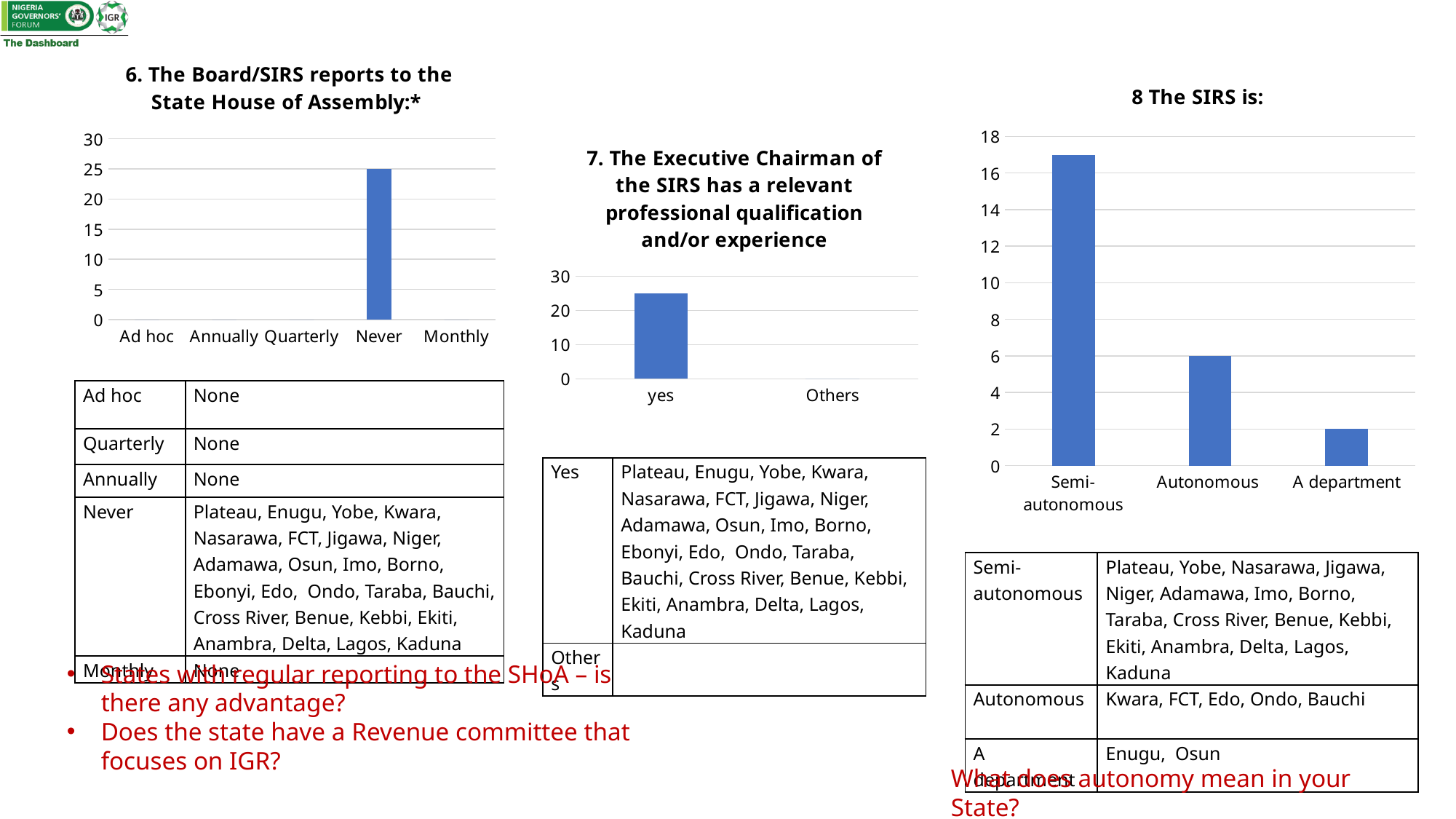
In the chart titled '8 The SIRS is:', which category has the highest value? Semi-autonomous In the chart titled '8 The SIRS is:', which category has the lowest value? A department In the chart titled '8 The SIRS is:', is the value for Semi-autonomous greater or less than 16? greater In the chart titled '8 The SIRS is:', what is the value for A department? 2 In the chart titled '6. The Board/SIRS reports to the State House of Assembly', which category has the highest value? Never In the chart titled '6. The Board/SIRS reports to the State House of Assembly', what is the value for Never? 25 In the chart titled '7. The Executive Chairman of the SIRS has a relevant professional qualification and/or experience', is the value for 'yes' greater or less than 20? greater How many categories are shown on the x axis of the chart titled '6. The Board/SIRS reports to the State House of Assembly'? 5 In the chart titled '7. The Executive Chairman of the SIRS has a relevant professional qualification and/or experience', which category has the higher value, yes or Others? yes In the chart titled '8 The SIRS is:', what is the difference between the values for Autonomous and A department? 4 In the chart titled '8 The SIRS is:', what is the value for Autonomous? 6 What kind of chart is the chart titled '7. The Executive Chairman of the SIRS has a relevant professional qualification and/or experience'? bar chart